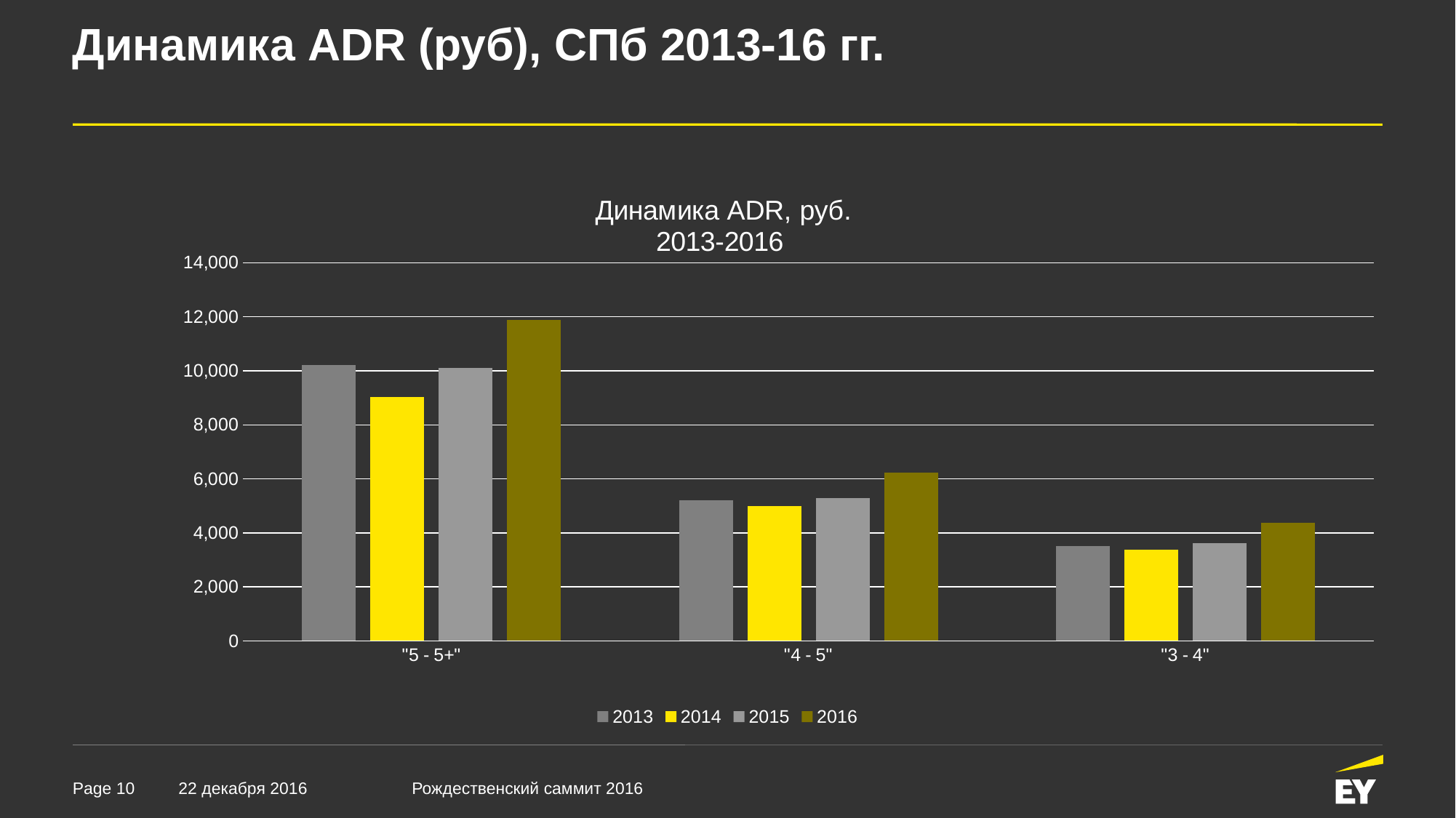
Is the 2016 value for "3 - 4" greater or less than 4,000? greater For the "5 - 5+" category, which year has the larger value: 2014 or 2016? 2016 Is the 2016 value for "5 - 5+" greater or less than 10,000? greater How many series does the legend list? 4 How many hotel categories are shown on the x axis? 3 What kind of chart is shown on the slide? Bar chart What is the title shown above the chart? Динамика ADR, руб. 2013-2016 Is the 2014 value for "4 - 5" greater or less than 6,000? less Which category has the lowest value for 2014? "3 - 4" Which category has the highest value for 2016? "5 - 5+" Within the "3 - 4" category, which year has the highest value? 2016